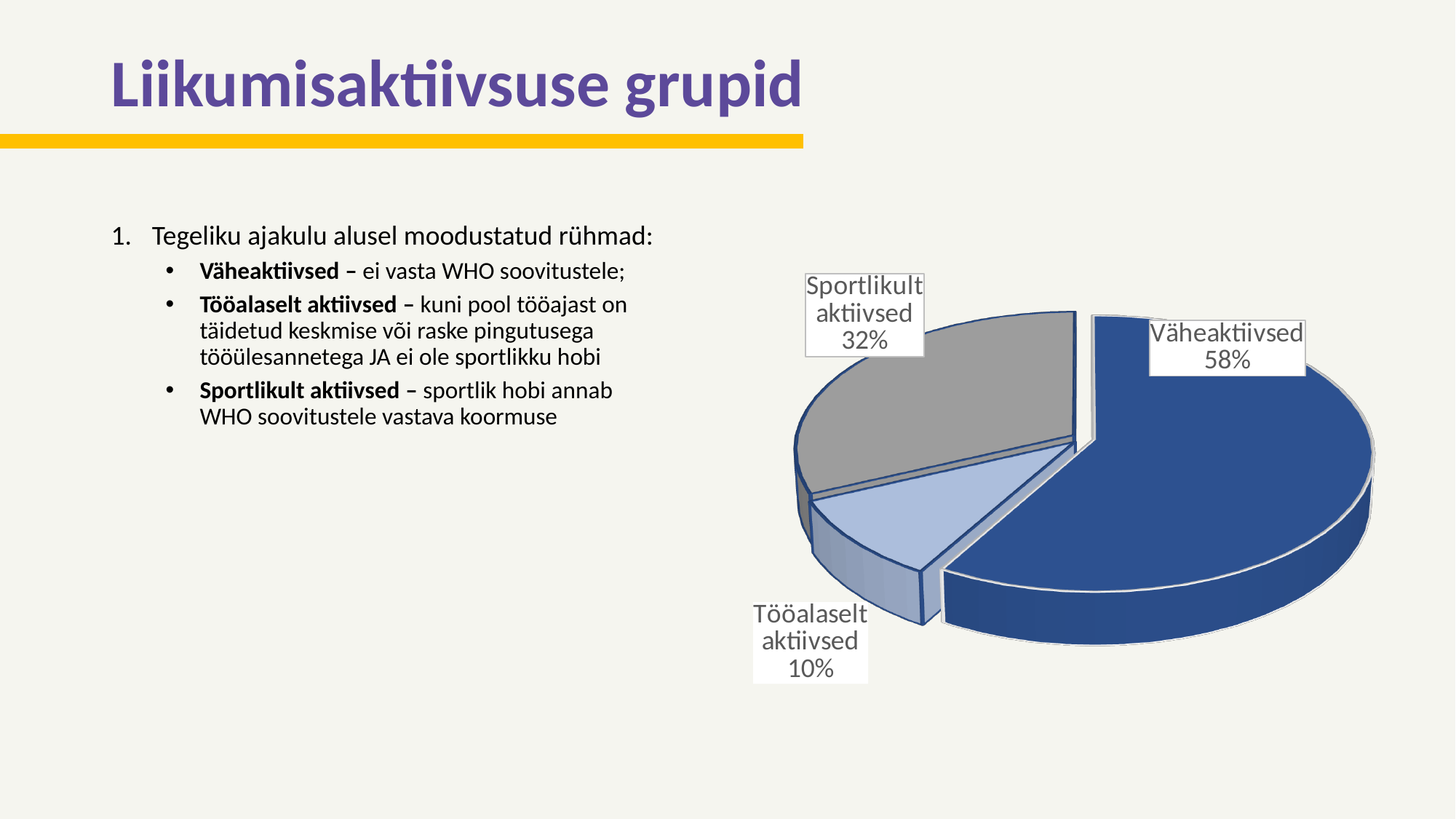
What kind of chart is shown on the slide? Pie chart What is the difference in percentage points between Sportlikult aktiivsed and Tööalaselt aktiivsed? 22 What share of the pie does Tööalaselt aktiivsed have? 10% What share of the pie does Sportlikult aktiivsed have? 32% How many slices does the pie chart have? 3 What share of the pie does Väheaktiivsed have? 58% Which is larger: the share for Sportlikult aktiivsed or the share for Tööalaselt aktiivsed? Sportlikult aktiivsed What colour is the Sportlikult aktiivsed slice? Grey What is the difference in percentage points between Väheaktiivsed and Sportlikult aktiivsed? 26 What colour is the Väheaktiivsed slice? Dark blue Which group has the smallest slice of the pie? Tööalaselt aktiivsed Which group has the largest slice of the pie? Väheaktiivsed